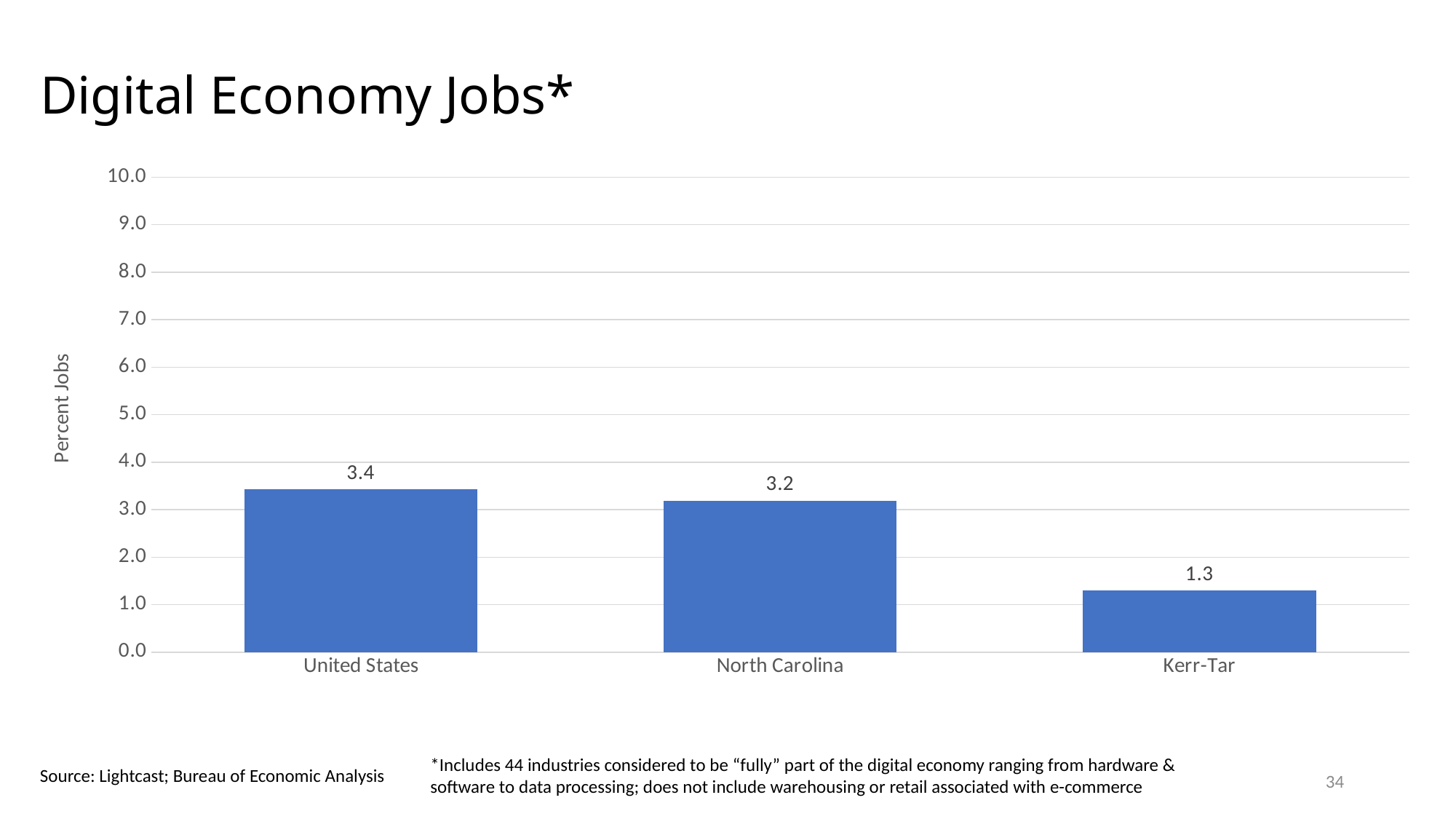
Is the value for Kerr-Tar greater or less than 2.0? less What is the value for North Carolina? 3.2 What is the label of the vertical axis? Percent Jobs Which category has the lowest value? Kerr-Tar What kind of chart is shown on the slide? bar chart How many categories are shown on the x axis? 3 What is the value for Kerr-Tar? 1.3 Which is larger, the value for North Carolina or the value for Kerr-Tar? North Carolina What is the difference between the values for United States and Kerr-Tar? 2.1 Which category has the highest value? United States What is the difference between the values for North Carolina and Kerr-Tar? 1.9 What is the value for United States? 3.4